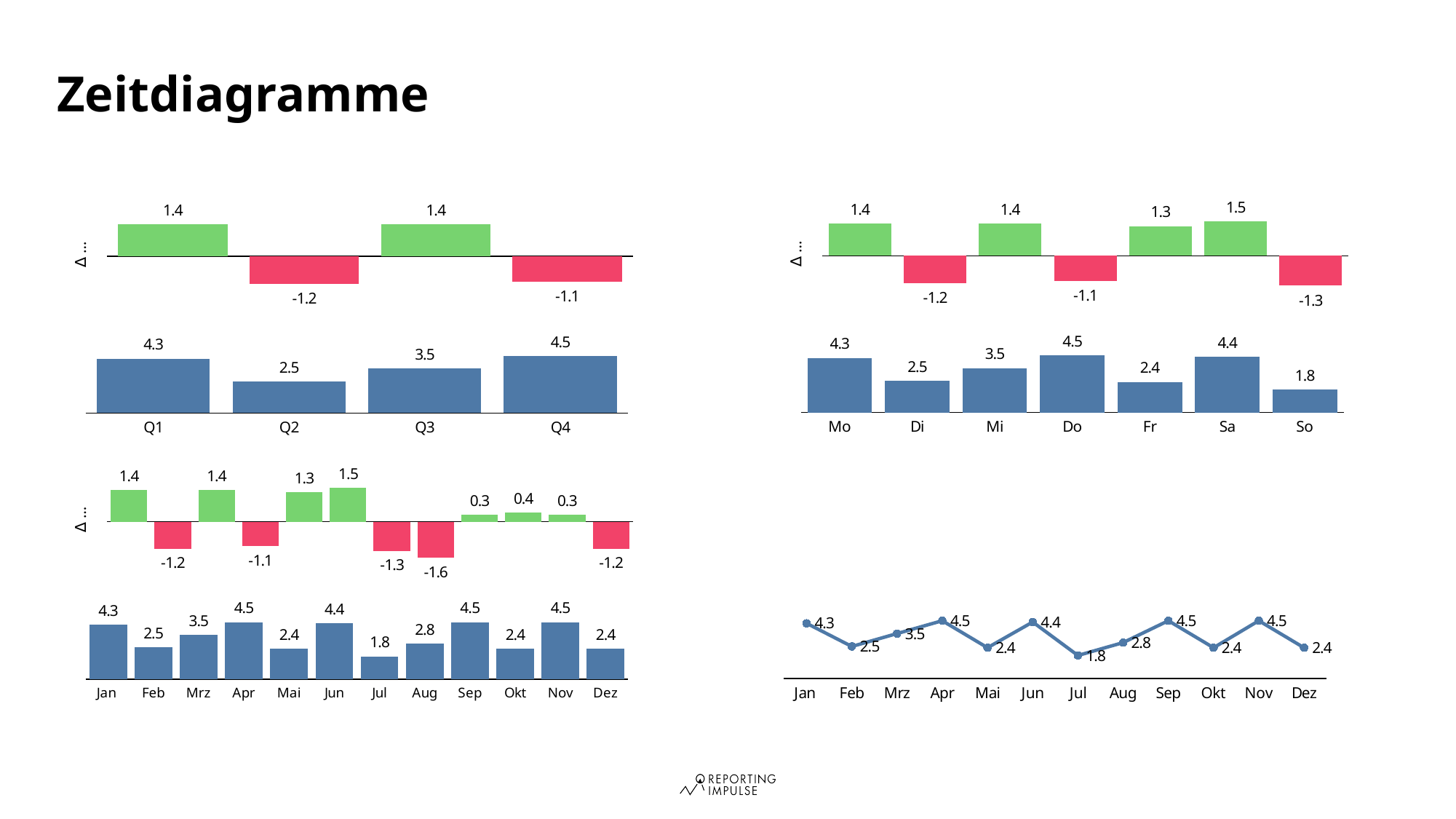
In the bottom-left monthly bar chart, which month has the lowest value? Jul In the bottom-right line chart, is the value for Mrz larger or smaller than the value for Feb? Larger In the top-right weekday bar chart, which day has the lowest value? So In the top-right weekday bar chart, what is the difference between the values for Do and Di? 2.0 In the top-right weekday bar chart, what is the value for Fr? 2.4 What kind of chart is the bottom-right chart with the Jan to Dez axis? Line chart In the bottom-left monthly bar chart, what is the value for Aug? 2.8 In the top-left quarterly bar chart, what is the value for Q3? 3.5 In the top-left quarterly bar chart, which quarter has the highest value? Q4 In the bottom-left monthly chart, what is the delta value shown above Aug? -1.6 In the top-left quarterly chart, what is the delta value shown above Q2? -1.2 How many categories are shown on the x axis of the top-right weekday bar chart? 7